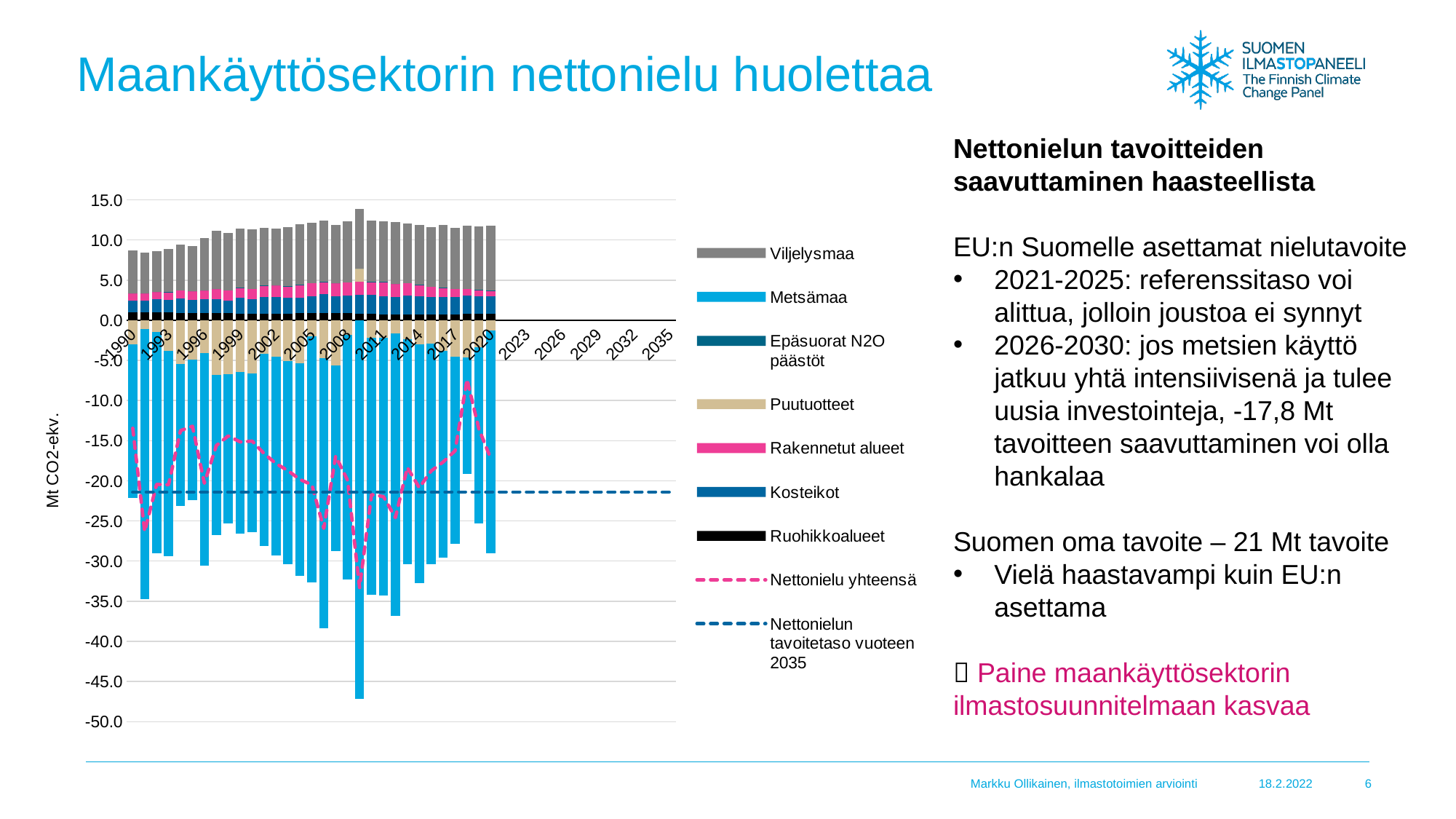
How many entries does the chart legend list? 9 Is the highest point of the Nettonielu yhteensä line greater or less than -10? greater What kind of chart is shown on the slide? bar chart (stacked bars with dashed lines) Is the Nettonielun tavoitetaso vuoteen 2035 dashed line greater or less than -25? greater Is the Nettonielun tavoitetaso vuoteen 2035 dashed line greater or less than -20? less Is the top of the positive stacked bar for 2020 higher or lower than for 1990? higher Which legend entry is shown in light blue? Metsämaa What is the lowest value shown on the vertical axis? -50.0 What is the label on the vertical axis of the chart? Mt CO2-ekv.